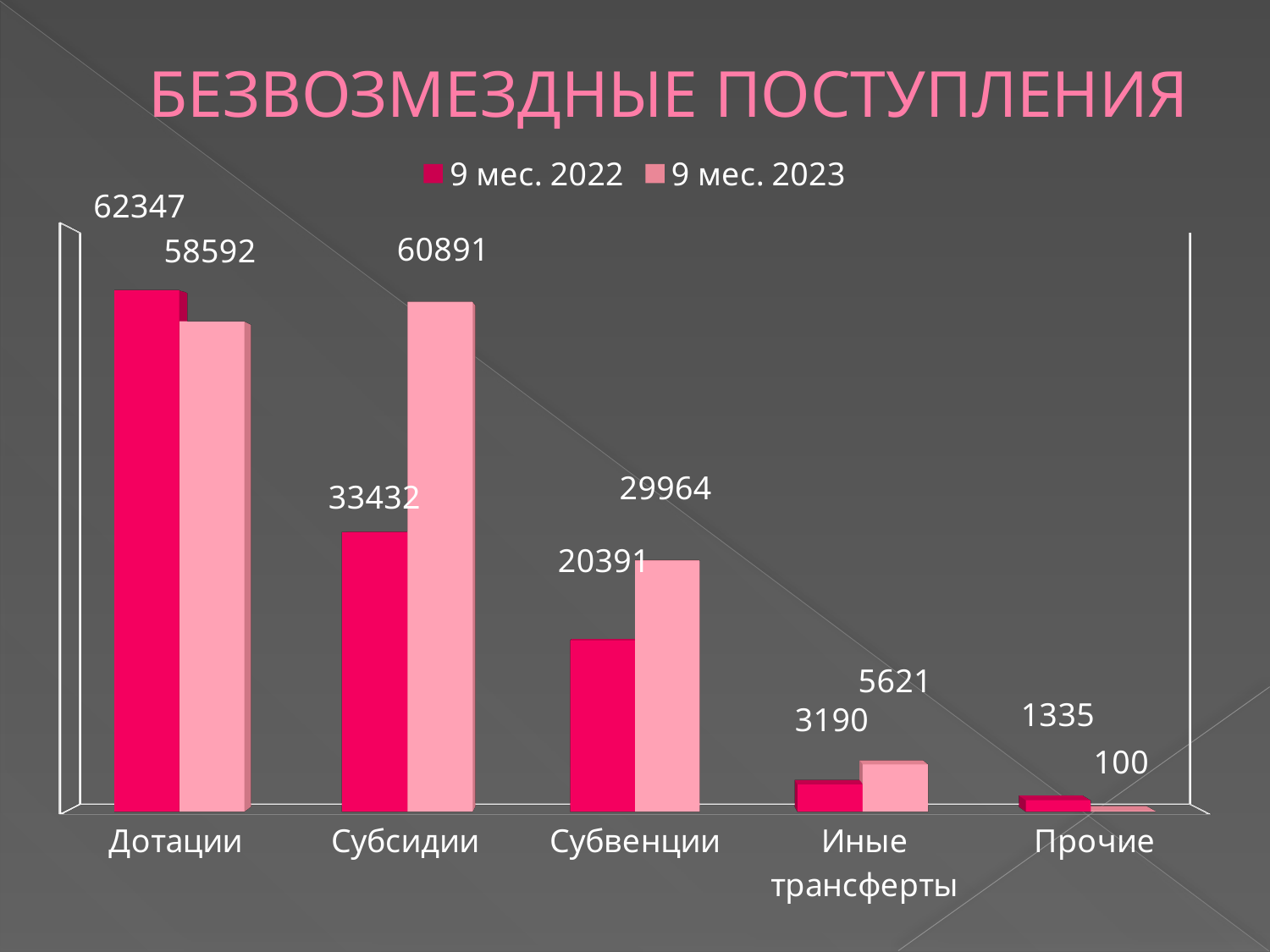
Which category has the highest value in the 9 мес. 2023 series? Субсидии For Иные трансферты, which series has the larger value, 9 мес. 2022 or 9 мес. 2023? 9 мес. 2023 What is the difference between the 9 мес. 2022 and 9 мес. 2023 values for Дотации? 3755 What kind of chart is shown on the slide? Bar chart Which category has the lowest value in the 9 мес. 2022 series? Прочие How many categories are shown on the x axis? 5 How many series does the legend list? 2 What is the value for Субвенции in the 9 мес. 2022 series? 20391 What is the value for Субсидии in the 9 мес. 2023 series? 60891 What is the value for Прочие in the 9 мес. 2023 series? 100 What is the difference between the 9 мес. 2023 and 9 мес. 2022 values for Субсидии? 27459 What is the value for Дотации in the 9 мес. 2022 series? 62347